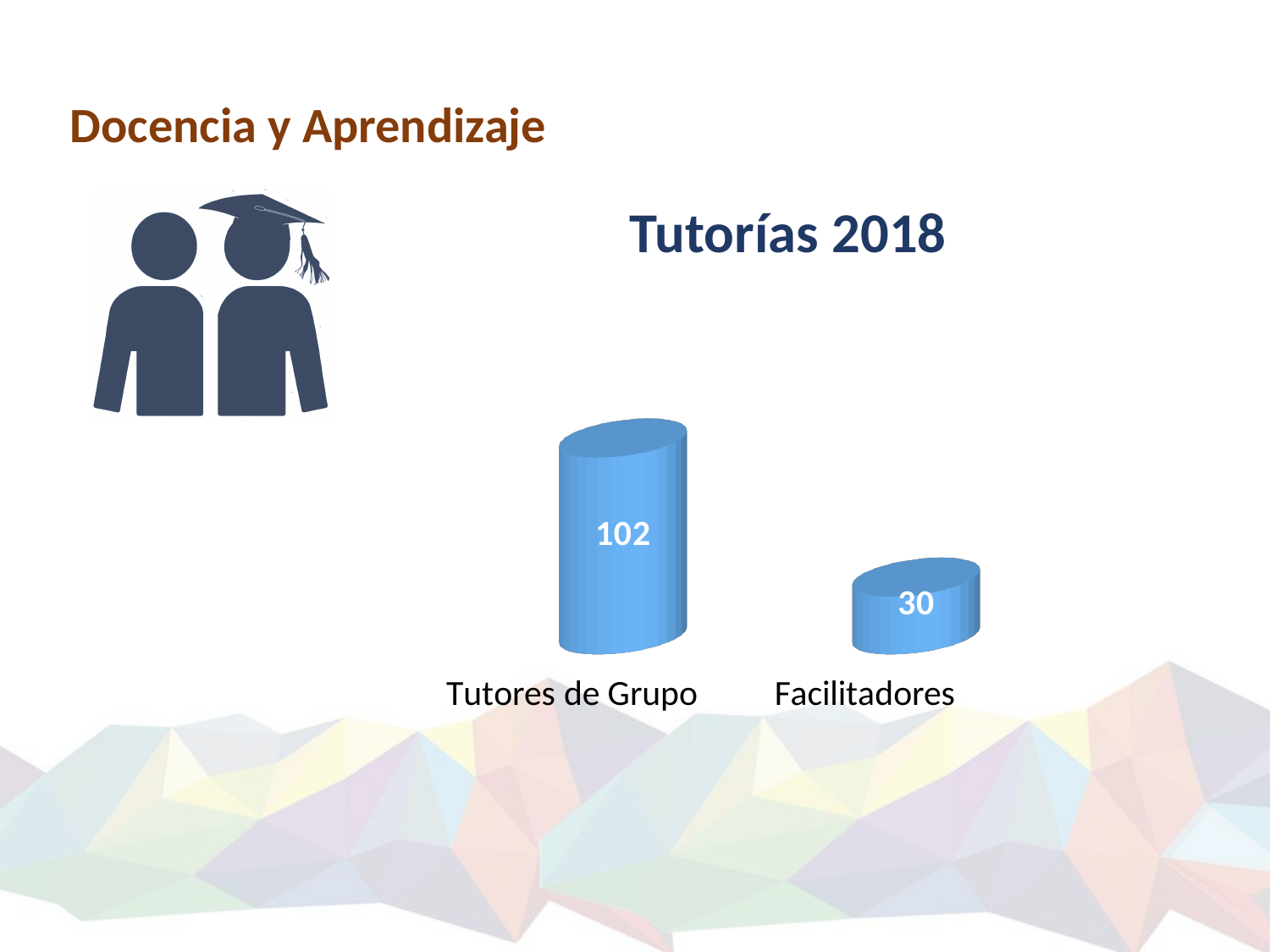
What is the value for Tutores de Grupo? 102 What is the title of the chart? Tutorías 2018 What kind of chart is shown on the slide? Bar chart What is the difference between the values for Tutores de Grupo and Facilitadores? 72 What is the total of the two values shown in the chart? 132 Which category has the highest value? Tutores de Grupo Which is larger, the value for Tutores de Grupo or the value for Facilitadores? Tutores de Grupo Which category has the lowest value? Facilitadores How many categories are shown in the chart? 2 What colour are the bars in the chart? Blue What is the value for Facilitadores? 30